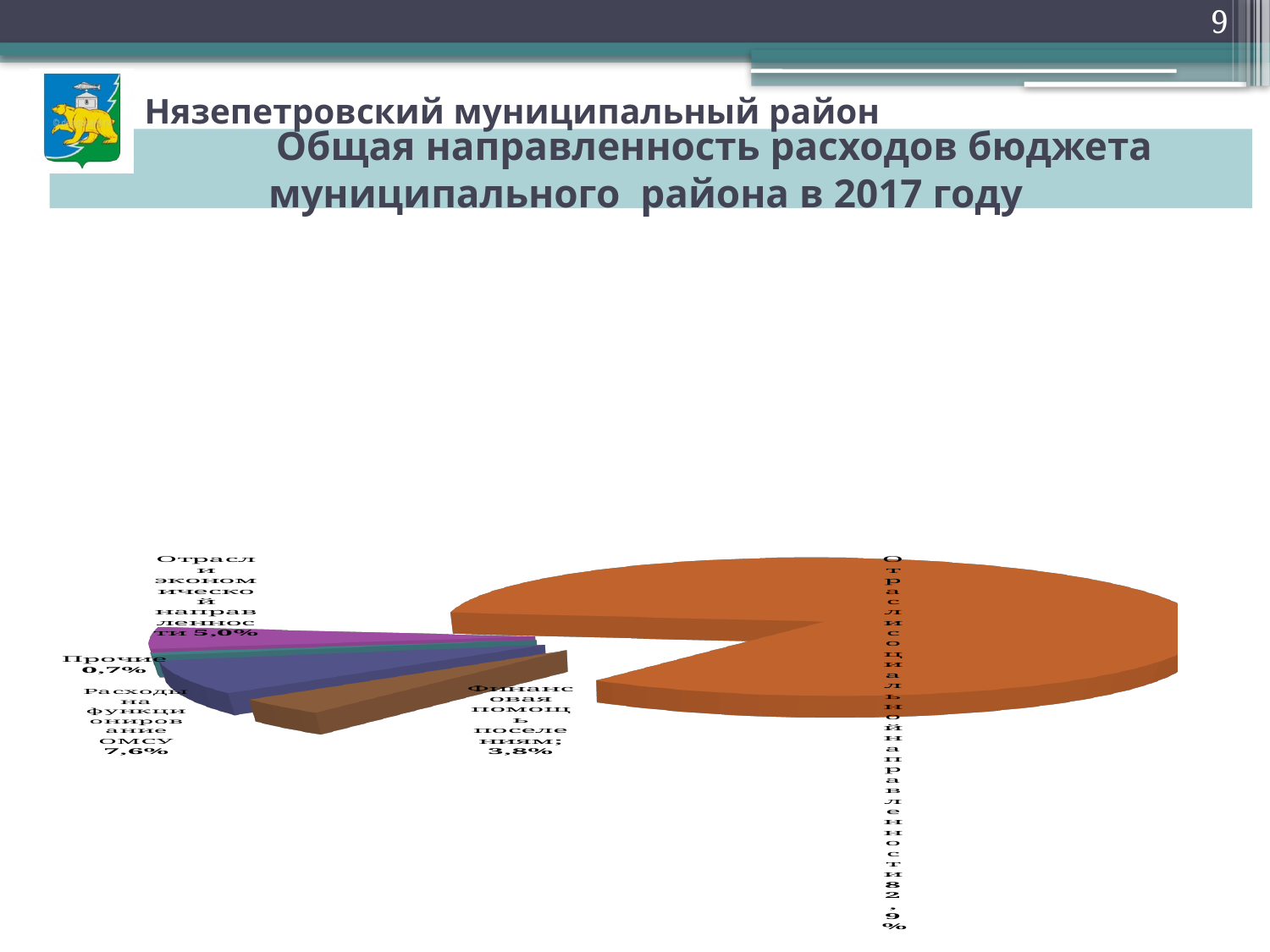
What share is shown for "Финансовая помощь поселениям"? 3,8% Which category has the smallest share of the pie? Прочие How many slices does the pie chart have? 5 What is the difference between the shares for "Расходы на функционирование ОМСУ" and "Финансовая помощь поселениям"? 3,8% What kind of chart is shown on the slide? Pie chart What share is shown for "Расходы на функционирование ОМСУ"? 7,6% What share is shown for "Прочие"? 0,7% What share of the pie is labelled for "Отрасли социальной направленности"? 82,9% Which is larger: the share for "Расходы на функционирование ОМСУ" or for "Отрасли экономической направленности"? Расходы на функционирование ОМСУ Which category has the largest share of the pie? Отрасли социальной направленности What share is shown for "Отрасли экономической направленности"? 5,0% What year does the chart title say the budget expenditures refer to? 2017